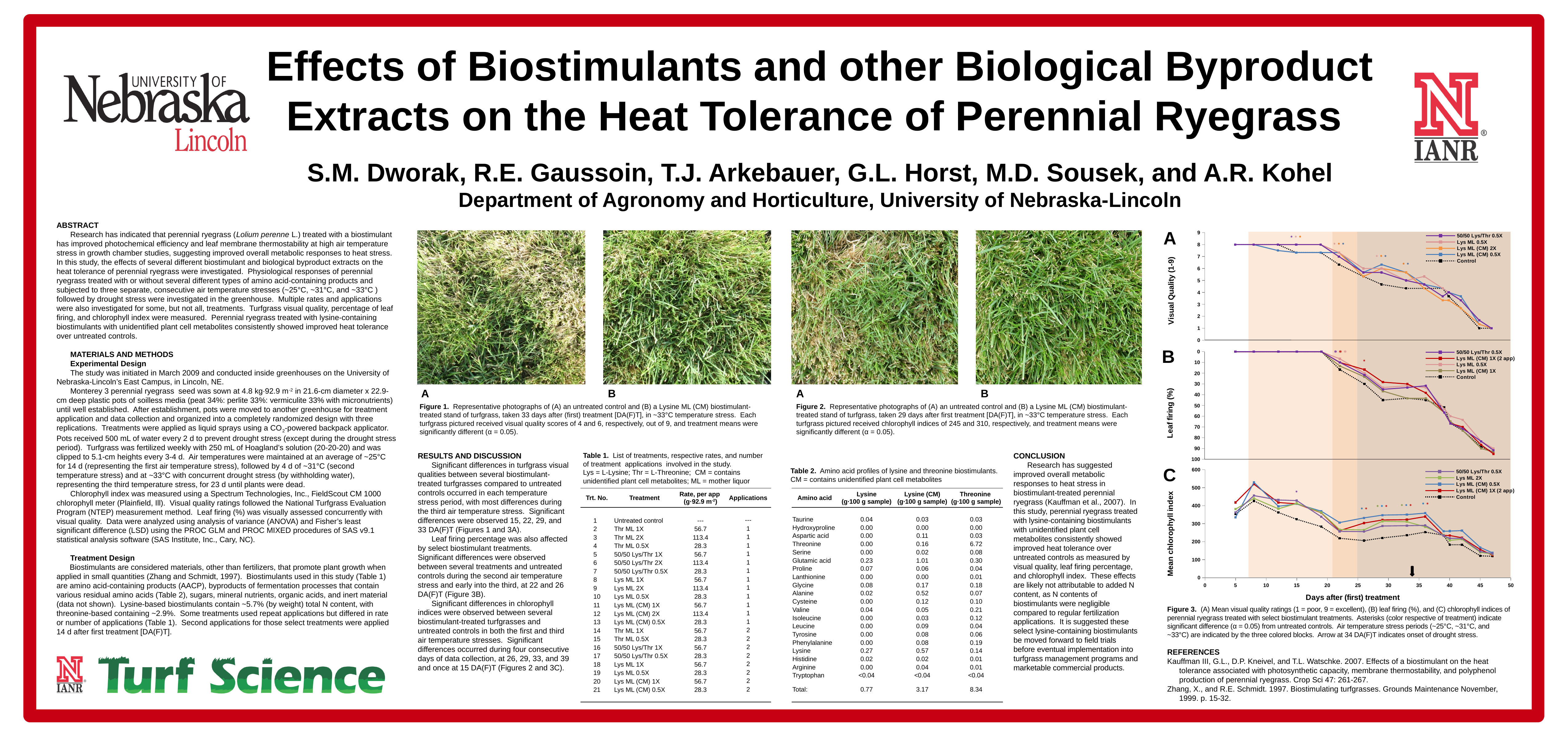
What is the x-axis title shared by the Figure 3 charts? Days after (first) treatment How many series does the legend of panel A (Visual Quality) of Figure 3 list? 5 In panel C (Mean chlorophyll index) of Figure 3, is the Control value at about 8 days after treatment greater or less than 300? greater How many series does the legend of panel C (Mean chlorophyll index) of Figure 3 list? 5 In panel A (Visual Quality) of Figure 3, is the Control value at about 47 days after treatment greater or less than 5? less What is the y-axis title of panel B of Figure 3? Leaf firing (%) In panel C (Mean chlorophyll index) of Figure 3, is the Control value at about 47 days after treatment greater or less than the Control value at about 8 days after treatment? less In panel A (Visual Quality) of Figure 3, do the visual quality values rise or fall as days after treatment increase? fall In panel B (Leaf firing) of Figure 3, is the Control leaf firing value at about 47 days after treatment greater or less than 80? greater What kind of chart is panel A (Visual Quality) of Figure 3? line chart